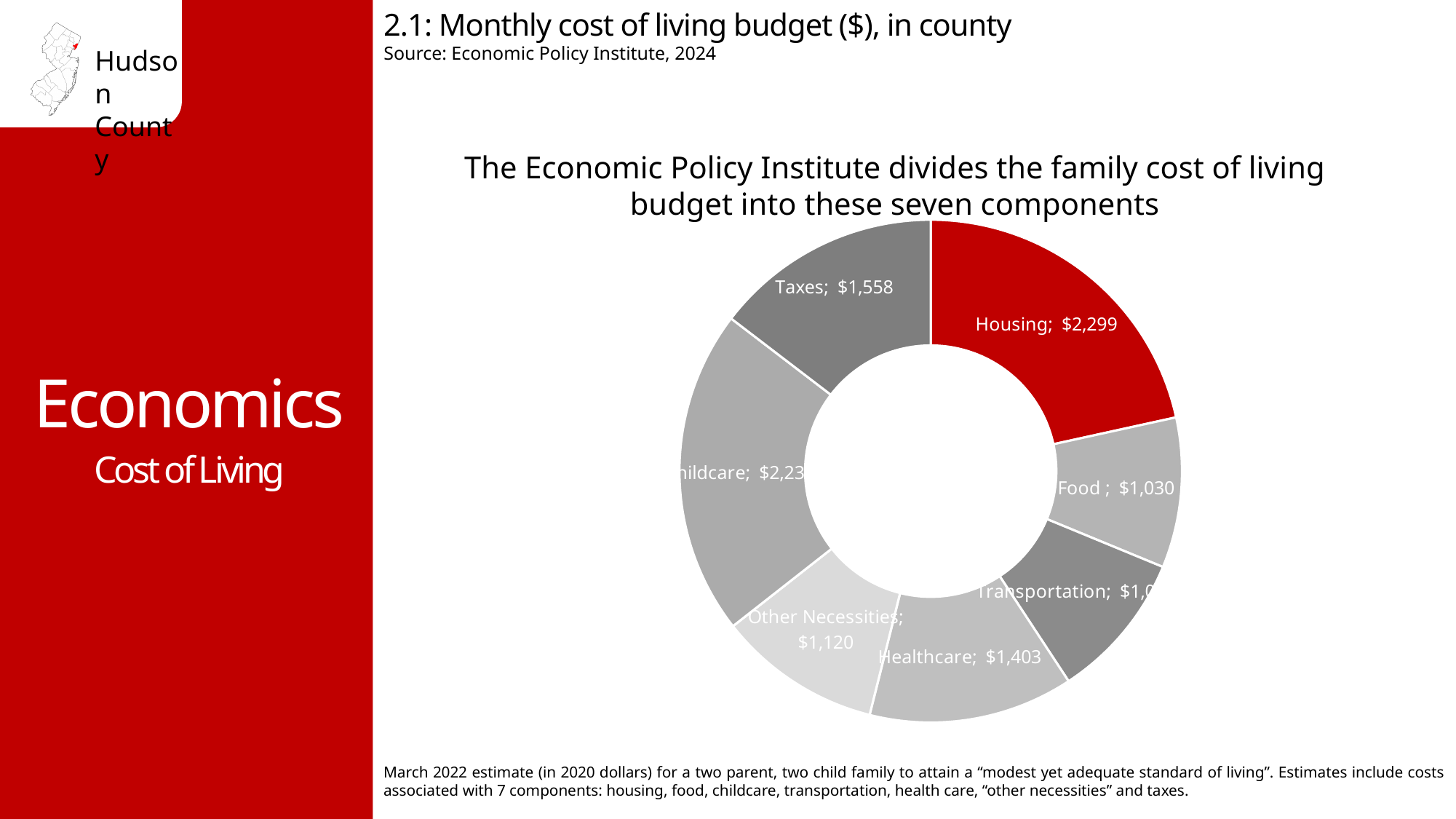
What is the monthly cost for Healthcare in the chart? $1,403 What is the monthly cost for Housing in the chart? $2,299 Which is larger, the cost for Taxes or the cost for Healthcare? Taxes How many components are shown in the chart? 7 What is the monthly cost for Food in the chart? $1,030 Which component has the highest monthly cost in the chart? Housing What is the difference between the Healthcare cost and the Food cost? $373 Which is larger, the cost for Other Necessities or the cost for Food? Other Necessities What is the monthly cost for Taxes in the chart? $1,558 What is the monthly cost for Other Necessities in the chart? $1,120 What kind of chart is shown on the slide? Pie (donut) chart What is the difference between the Housing cost and the Taxes cost? $741